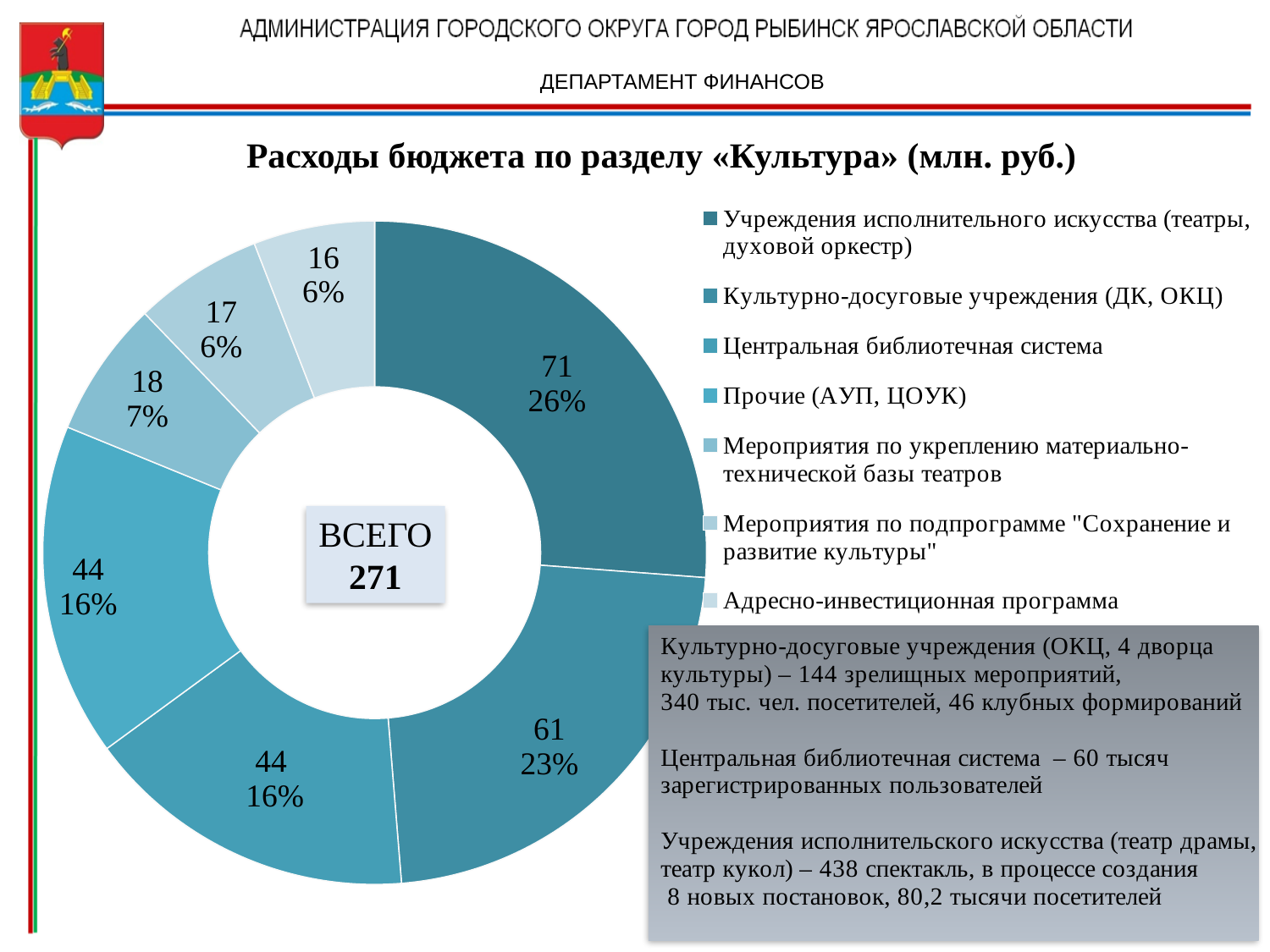
Which category has the largest share of the chart? Учреждения исполнительного искусства (театры, духовой оркестр) What share of the chart does «Центральная библиотечная система» represent? 16% What is the title of the chart? Расходы бюджета по разделу «Культура» (млн. руб.) Which category has the smallest share of the chart? Адресно-инвестиционная программа What kind of chart is shown on the slide? Doughnut (pie) chart What is the value for «Учреждения исполнительного искусства (театры, духовой оркестр)»? 71 What is the total shown in the centre of the chart? 271 What is the value for «Культурно-досуговые учреждения (ДК, ОКЦ)»? 61 What is the value for «Адресно-инвестиционная программа»? 16 How many slices does the chart have? 7 What is the difference between the values for «Учреждения исполнительного искусства» and «Культурно-досуговые учреждения»? 10 How many entries does the legend list? 7